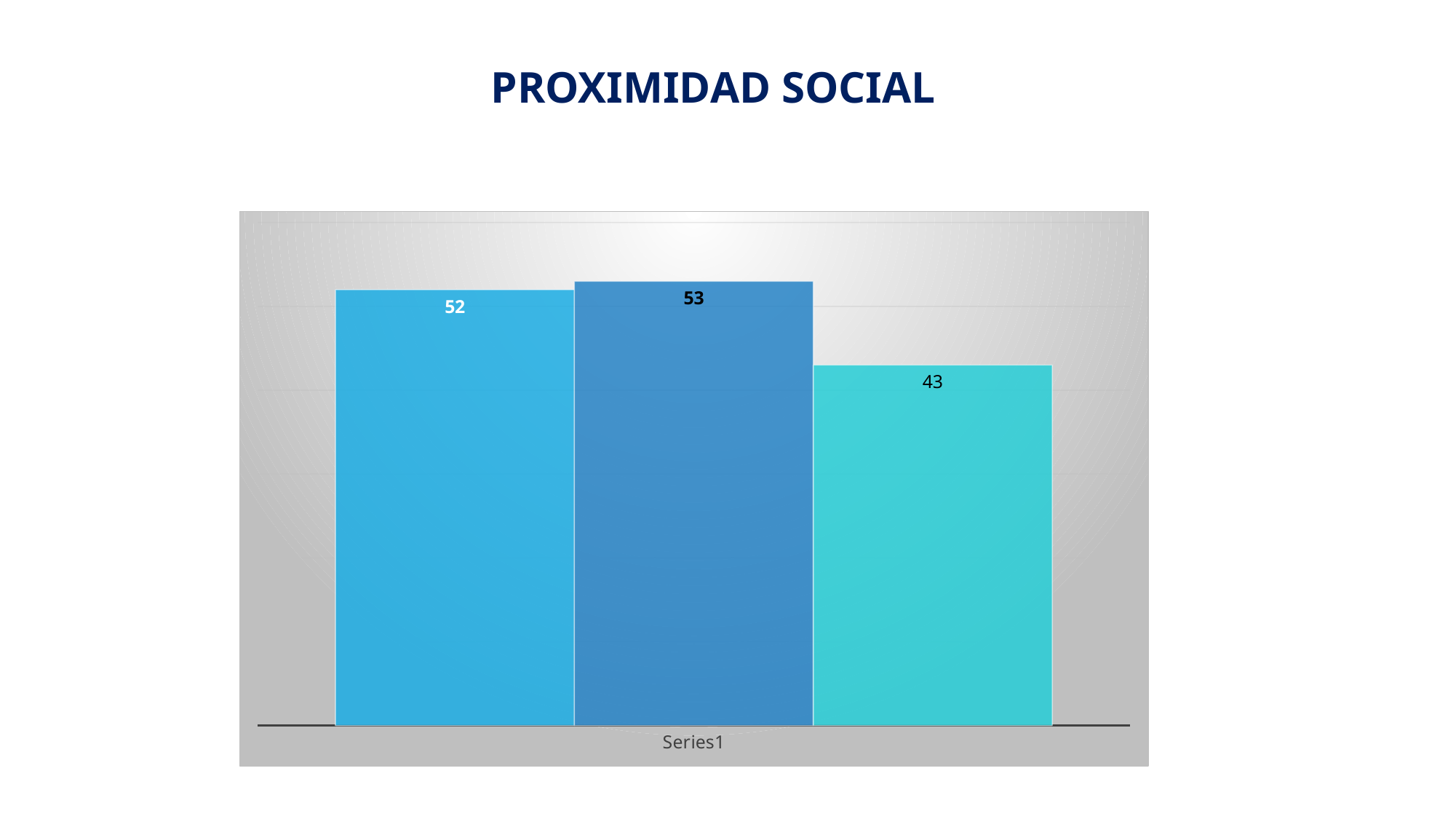
What is the value of the leftmost (light blue) bar? 52 What is the difference between the leftmost bar (52) and the rightmost bar (43)? 9 Which is larger, the value of the leftmost bar or the value of the rightmost bar? the leftmost bar (52) What is the category label shown on the x axis? Series1 What type of chart is shown on the slide? bar chart What is the total of the three bar values shown? 148 What is the difference between the middle bar (53) and the rightmost bar (43)? 10 What is the title of the chart? PROXIMIDAD SOCIAL Which bar has the lowest value? the rightmost (teal) bar, 43 What is the value of the rightmost (teal) bar? 43 What is the value of the middle (dark blue) bar? 53 How many bars are plotted in the chart? 3